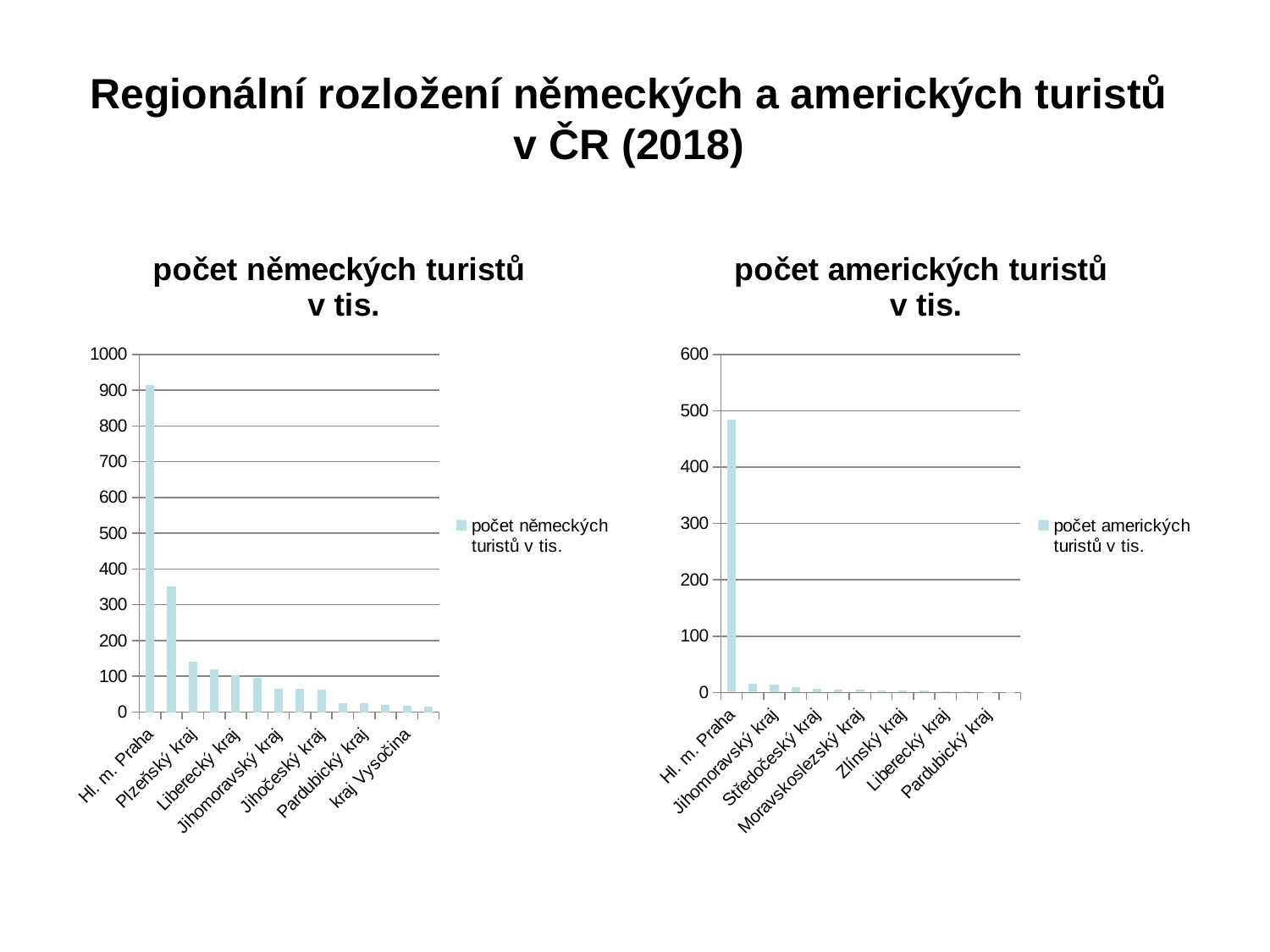
In the left chart 'počet německých turistů v tis.', is the value for Jihomoravský kraj greater or less than 100? less In the left chart 'počet německých turistů v tis.', is the value for Hl. m. Praha greater or less than 800? greater In the left chart 'počet německých turistů v tis.', is the value for Plzeňský kraj greater or less than 300? less How many series does the legend of the right chart 'počet amerických turistů v tis.' list? 1 In the right chart 'počet amerických turistů v tis.', which region has the highest value? Hl. m. Praha Do the values in the left chart 'počet německých turistů v tis.' rise or fall from left to right along the x axis? fall In the left chart 'počet německých turistů v tis.', which region has the highest value? Hl. m. Praha In the left chart 'počet německých turistů v tis.', which is larger, the value for Hl. m. Praha or for Plzeňský kraj? Hl. m. Praha What is the legend entry of the left chart? počet německých turistů v tis. What kind of chart is the left chart, 'počet německých turistů v tis.'? bar chart